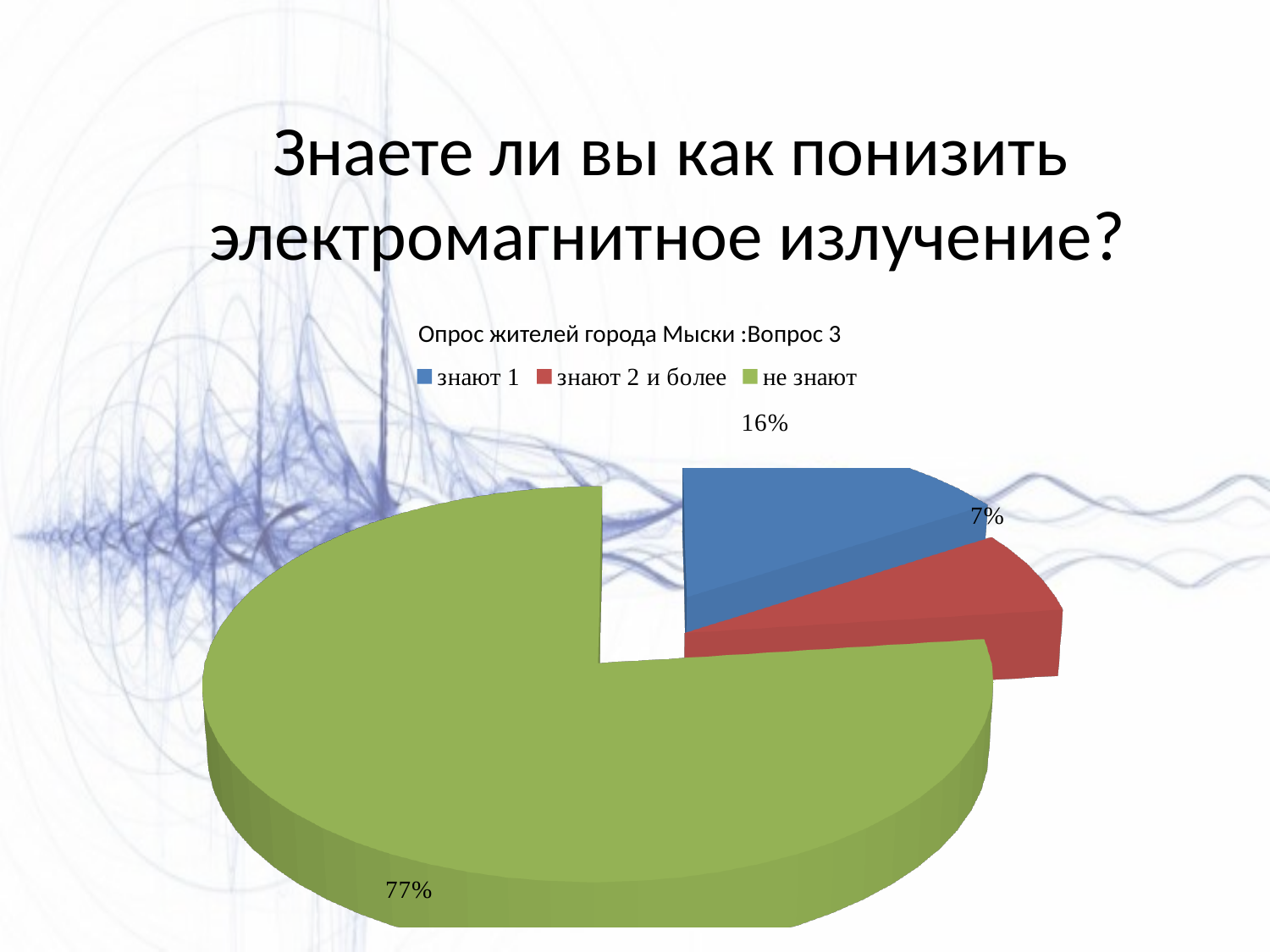
Which category has the smallest slice of the pie? знают 2 и более Which colour represents "не знают" in the chart? green Which is larger: the share for "знают 1" or the share for "знают 2 и более"? знают 1 What share of the pie is labelled for "знают 2 и более"? 7% What share of the pie is labelled for "знают 1"? 16% How many entries does the chart legend list? 3 What kind of chart is shown on the slide? pie chart What share of the pie is labelled for "не знают"? 77% What is the difference between the share for "не знают" and the share for "знают 1"? 61% Which category has the largest slice of the pie? не знают What is the title of the chart? Опрос жителей города Мыски :Вопрос 3 How many slices does the pie chart have? 3